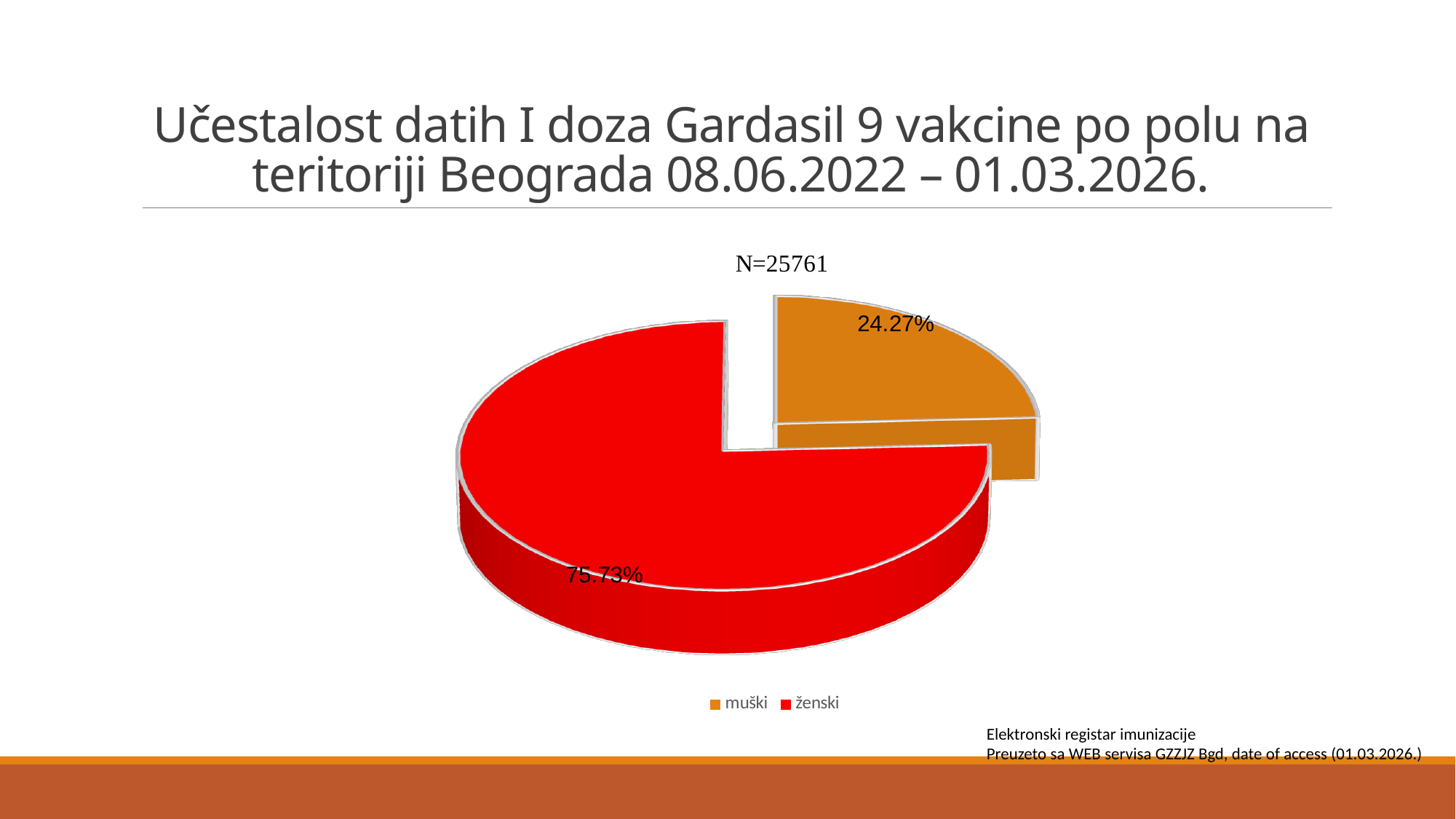
What colour is the 'ženski' slice in the pie chart? red How many categories does the pie chart show? 2 Which is larger, the share for 'muški' or the share for 'ženski'? ženski What share of the pie does the 'muški' slice represent? 24.27% What share of the pie does the 'ženski' slice represent? 75.73% What is the total N shown above the pie chart? N=25761 What is the difference in percentage points between the 'ženski' and 'muški' shares? 51.46 Which category has the largest slice of the pie? ženski What kind of chart is shown on the slide? pie chart Which category has the smallest slice of the pie? muški How many entries does the legend list? 2